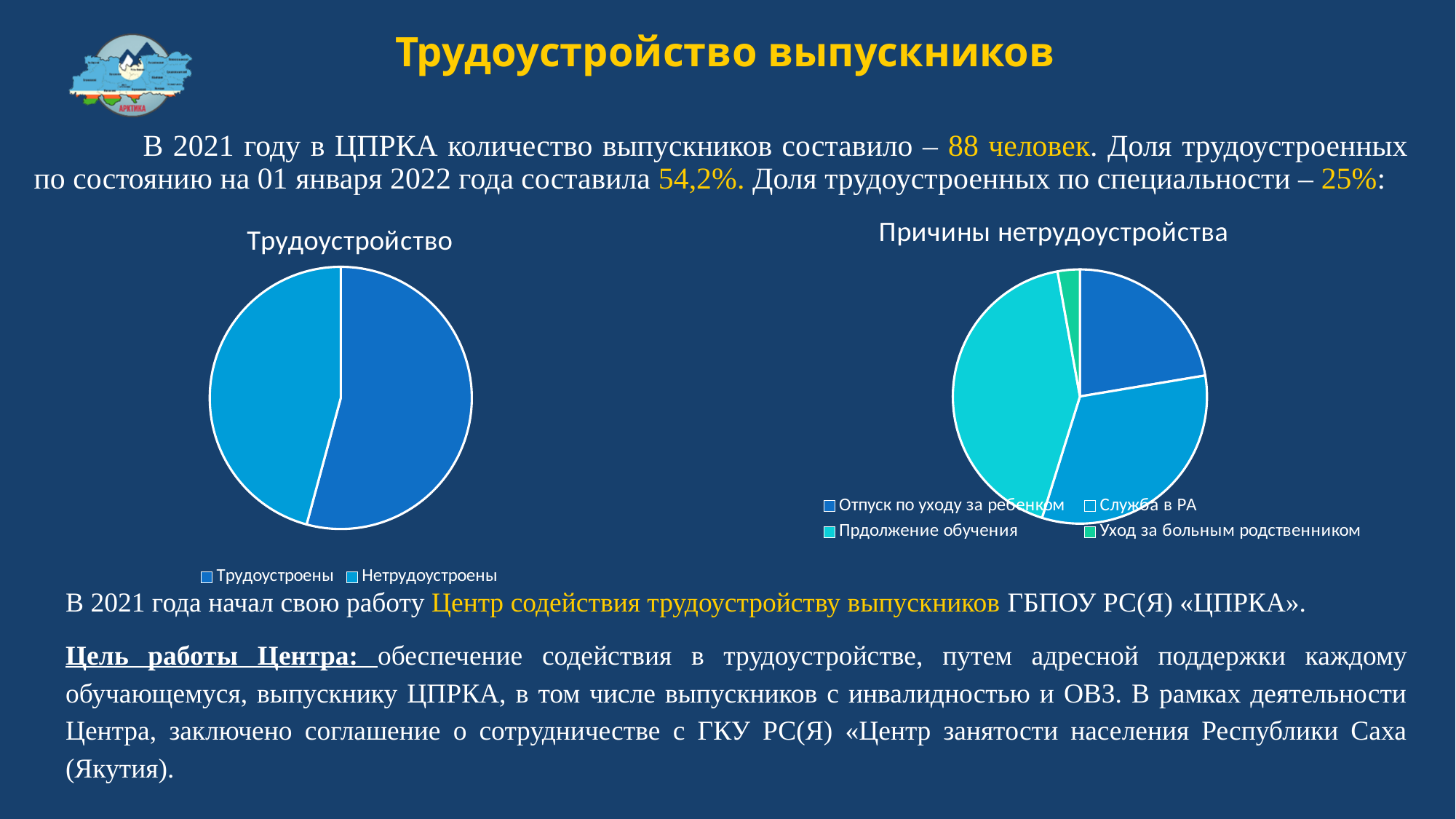
In the "Причины нетрудоустройства" pie chart, which category has the largest slice? Прдолжение обучения How many entries does the legend of the "Причины нетрудоустройства" chart list? 4 In the "Причины нетрудоустройства" pie chart, which slice is larger: "Продолжение обучения" or "Уход за больным родственником"? Прдолжение обучения How many entries does the legend of the "Трудоустройство" chart list? 2 What is the title of the pie chart on the right side of the slide? Причины нетрудоустройства How many slices does the "Трудоустройство" pie chart have? 2 What kind of chart is the "Трудоустройство" chart on the left? Pie chart In the "Причины нетрудоустройства" pie chart, which slice is larger: "Служба в РА" or "Отпуск по уходу за ребенком"? Служба в РА What kind of chart is the "Причины нетрудоустройства" chart on the right? Pie chart In the "Трудоустройство" pie chart, which slice is larger: "Трудоустроены" or "Нетрудоустроены"? Трудоустроены In the "Причины нетрудоустройства" pie chart, which category has the smallest slice? Уход за больным родственником How many slices does the "Причины нетрудоустройства" pie chart have? 4